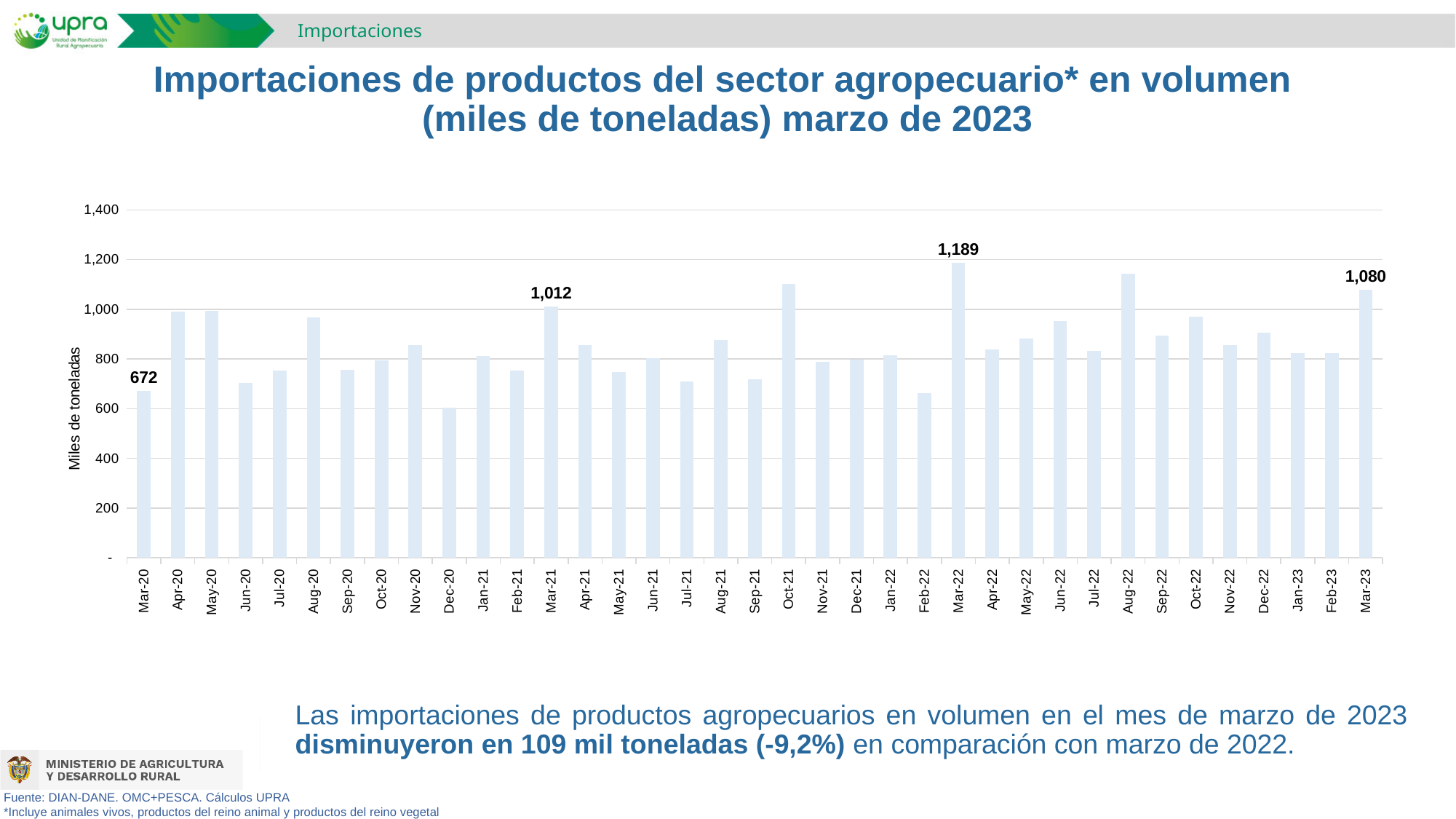
What is the value for Mar-22? 1,189 How many months are plotted on the chart? 37 Is the value for Oct-21 greater or less than 1,000? greater Which month has the lowest value? Dec-20 What is the value for Mar-21? 1,012 Which month has the highest value? Mar-22 What is the difference between the values for Mar-22 and Mar-23? 109 What kind of chart is shown? bar chart What is the value for Mar-23? 1,080 Which is larger, the value for Mar-20 or the value for Mar-21? Mar-21 What is the difference between the values for Mar-21 and Mar-20? 340 What is the value for Mar-20? 672